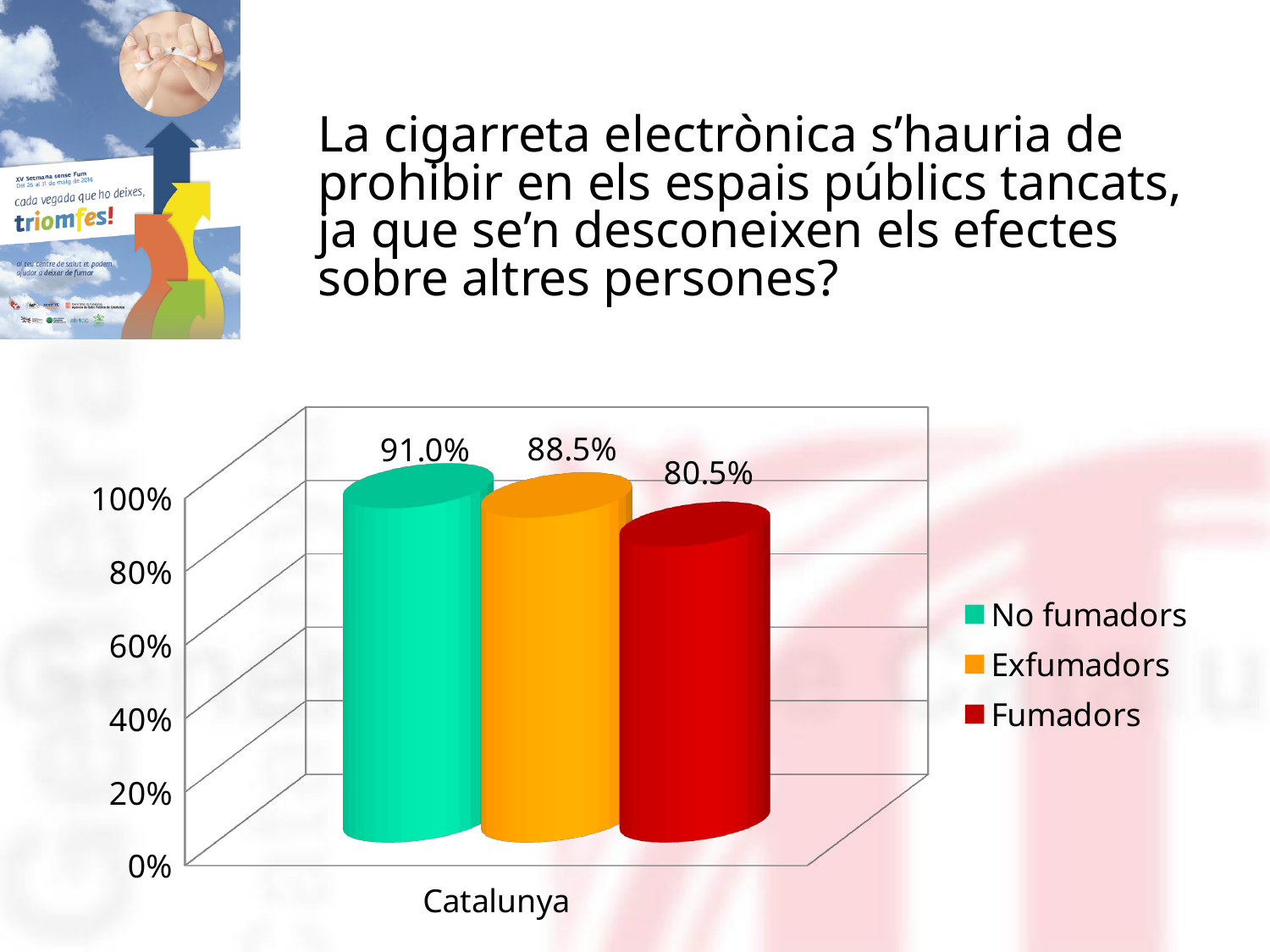
Which series has the highest value? No fumadors What is the category label shown on the x axis? Catalunya What is the value for No fumadors? 91.0% What is the value for Exfumadors? 88.5% What kind of chart is shown on the slide? bar chart Which is larger, the value for Exfumadors or the value for Fumadors? Exfumadors Which series has the lowest value? Fumadors What is the difference between the values for No fumadors and Fumadors? 10.5% What is the value for Fumadors? 80.5% What is the difference between the values for Exfumadors and Fumadors? 8.0% How many series does the legend list? 3 Is the value for Fumadors greater or less than 80%? greater